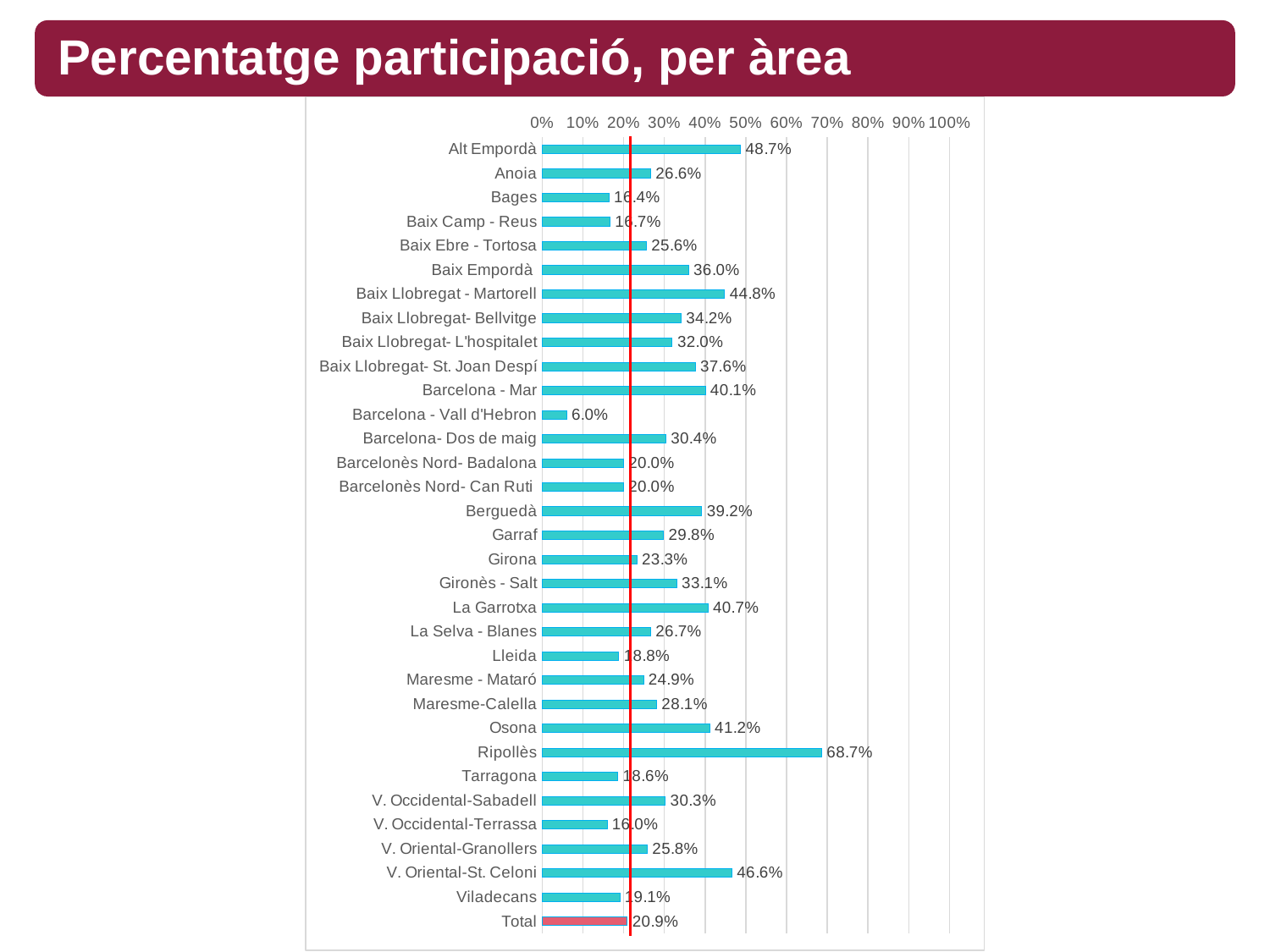
What is the participation percentage for Barcelona - Vall d'Hebron? 6.0% How many bars are shown in the chart, including Total? 33 What is the title of the slide? Percentatge participació, per àrea What kind of chart is shown on the slide? bar chart Which bar is coloured differently (red) from the others? Total Which area has the highest participation percentage? Ripollès Which has a higher participation percentage, Osona or La Garrotxa? Osona What is the value shown for Total? 20.9% Which area has the lowest participation percentage? Barcelona - Vall d'Hebron What is the difference between the participation percentages of Alt Empordà and Anoia? 22.1% What is the participation percentage for Ripollès? 68.7% Is the value for Baix Llobregat - Martorell greater or less than 40%? greater